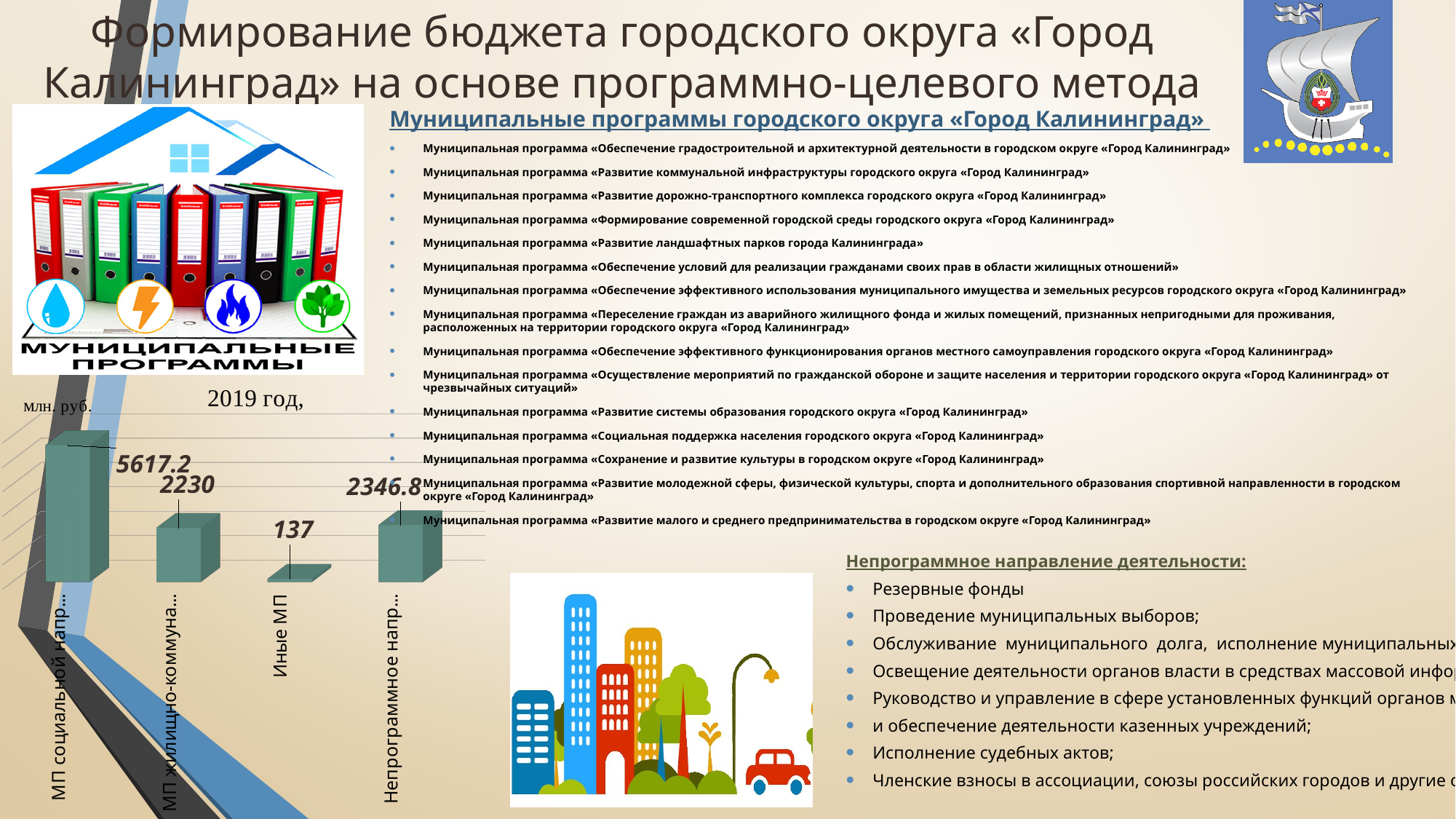
What is the value for the «МП социальной напр...» bar in the chart? 5617.2 Which category has the highest value in the bar chart? МП социальной напр... How many bars are shown in the chart? 4 What is the value for the «МП жилищно-коммуна...» bar in the chart? 2230 Which is larger: the value for «Непрограммное напр...» or for «МП жилищно-коммуна...»? Непрограммное напр... What type of chart is shown on the slide? bar chart Which category has the lowest value in the bar chart? Иные МП What is the difference between the «МП социальной напр...» value and the «Иные МП» value? 5480.2 What unit is indicated for the values in the bar chart? млн. руб. What is the value for the «Непрограммное напр...» bar in the chart? 2346.8 What is the difference between the «Непрограммное напр...» value and the «МП жилищно-коммуна...» value? 116.8 What is the value for «Иные МП» in the bar chart? 137